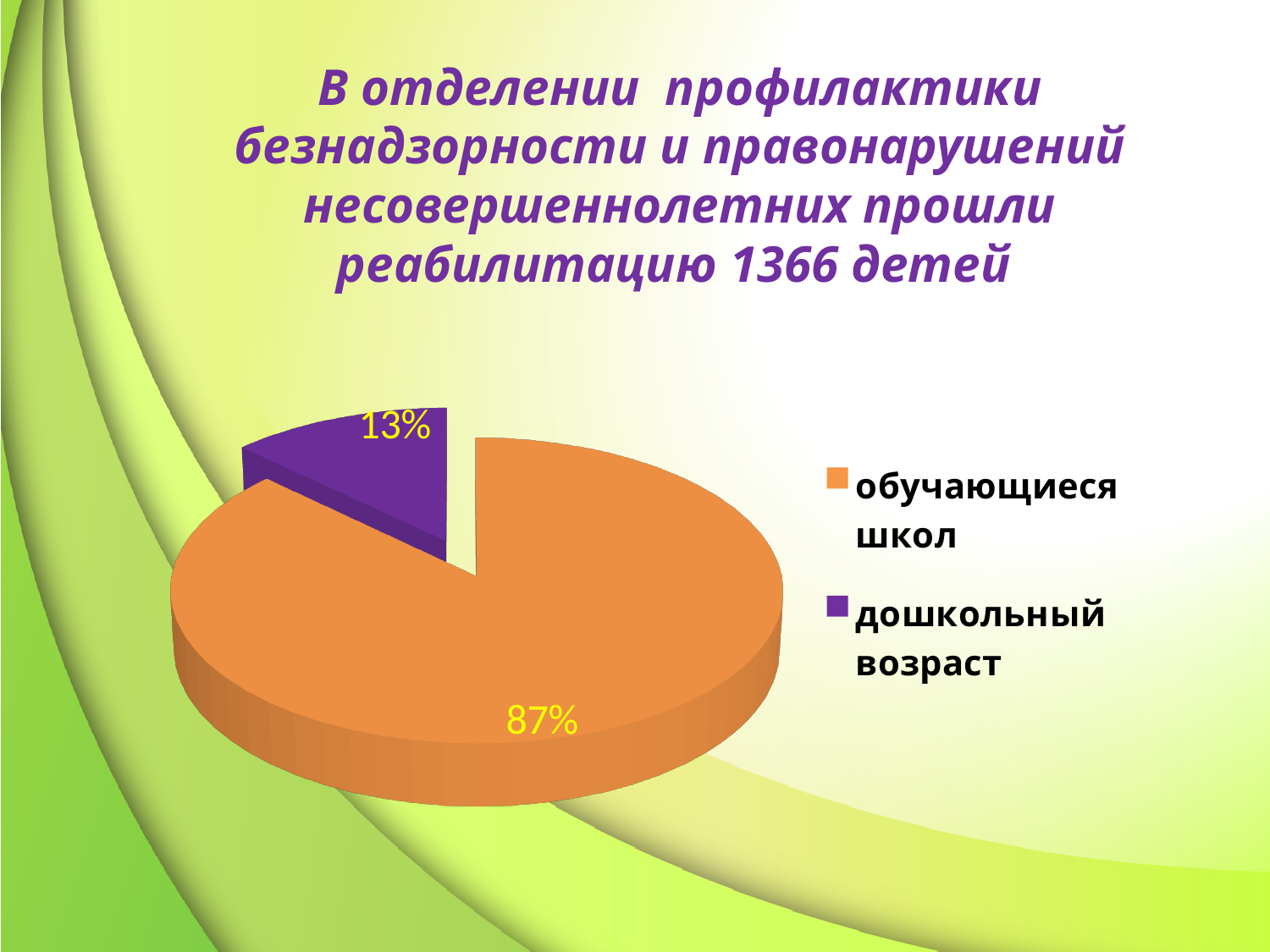
Which category has the smallest slice of the pie? дошкольный возраст What kind of chart is shown on the slide? pie chart How many categories does the pie chart show? 2 Which category has the largest slice of the pie? обучающиеся школ How many children in total are mentioned in the slide title as having completed rehabilitation? 1366 What share of the pie is labelled for обучающиеся школ? 87% What colour is the slice for обучающиеся школ? orange Which slice is larger: обучающиеся школ or дошкольный возраст? обучающиеся школ What is the difference in percentage points between the обучающиеся школ slice and the дошкольный возраст slice? 74 What colour is the slice for дошкольный возраст? purple What share of the pie is labelled for дошкольный возраст? 13%